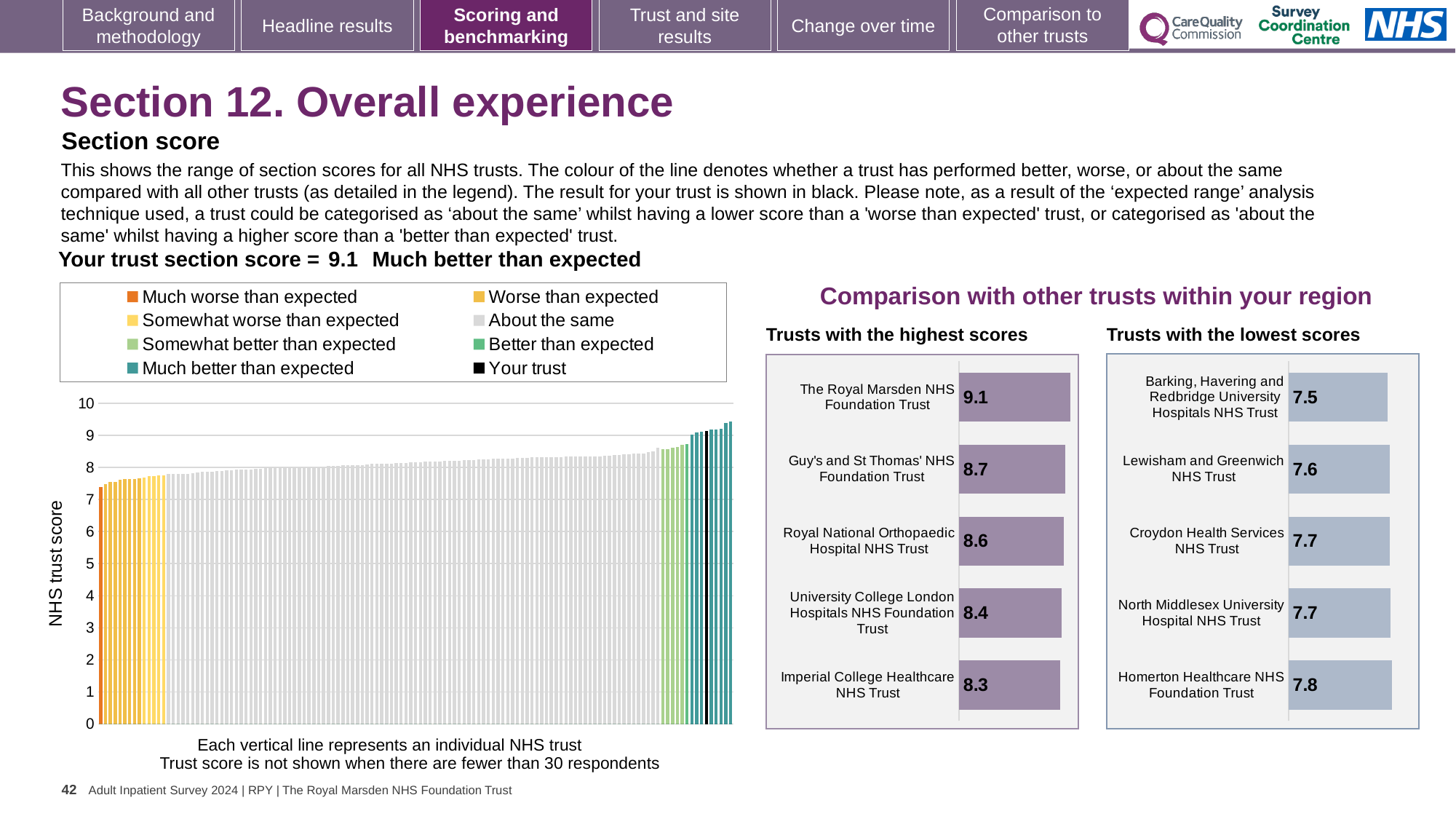
In the 'Trusts with the highest scores' chart, what is the score for Guy's and St Thomas' NHS Foundation Trust? 8.7 In the 'Trusts with the lowest scores' chart, which has the larger score: Lewisham and Greenwich NHS Trust or Homerton Healthcare NHS Foundation Trust? Homerton Healthcare NHS Foundation Trust In the NHS trust score chart on the left, do the values rise or fall from left to right? rise In the 'Trusts with the lowest scores' chart, how much higher is Homerton Healthcare NHS Foundation Trust's score than Barking, Havering and Redbridge University Hospitals NHS Trust's score? 0.3 In the 'Trusts with the lowest scores' chart, which trust has the lowest score? Barking, Havering and Redbridge University Hospitals NHS Trust How many trusts are shown in the 'Trusts with the highest scores' chart? 5 In the 'Trusts with the highest scores' chart, what is the difference between the scores of The Royal Marsden NHS Foundation Trust and Imperial College Healthcare NHS Trust? 0.8 How many entries does the legend of the NHS trust score chart on the left list? 8 In the 'Trusts with the highest scores' chart, which trust has the highest score? The Royal Marsden NHS Foundation Trust In the NHS trust score chart on the left, what is the section score for your trust (the black bar)? 9.1 In the 'Trusts with the lowest scores' chart, what is the score for Croydon Health Services NHS Trust? 7.7 What kind of chart is the NHS trust score chart on the left of the slide? bar chart